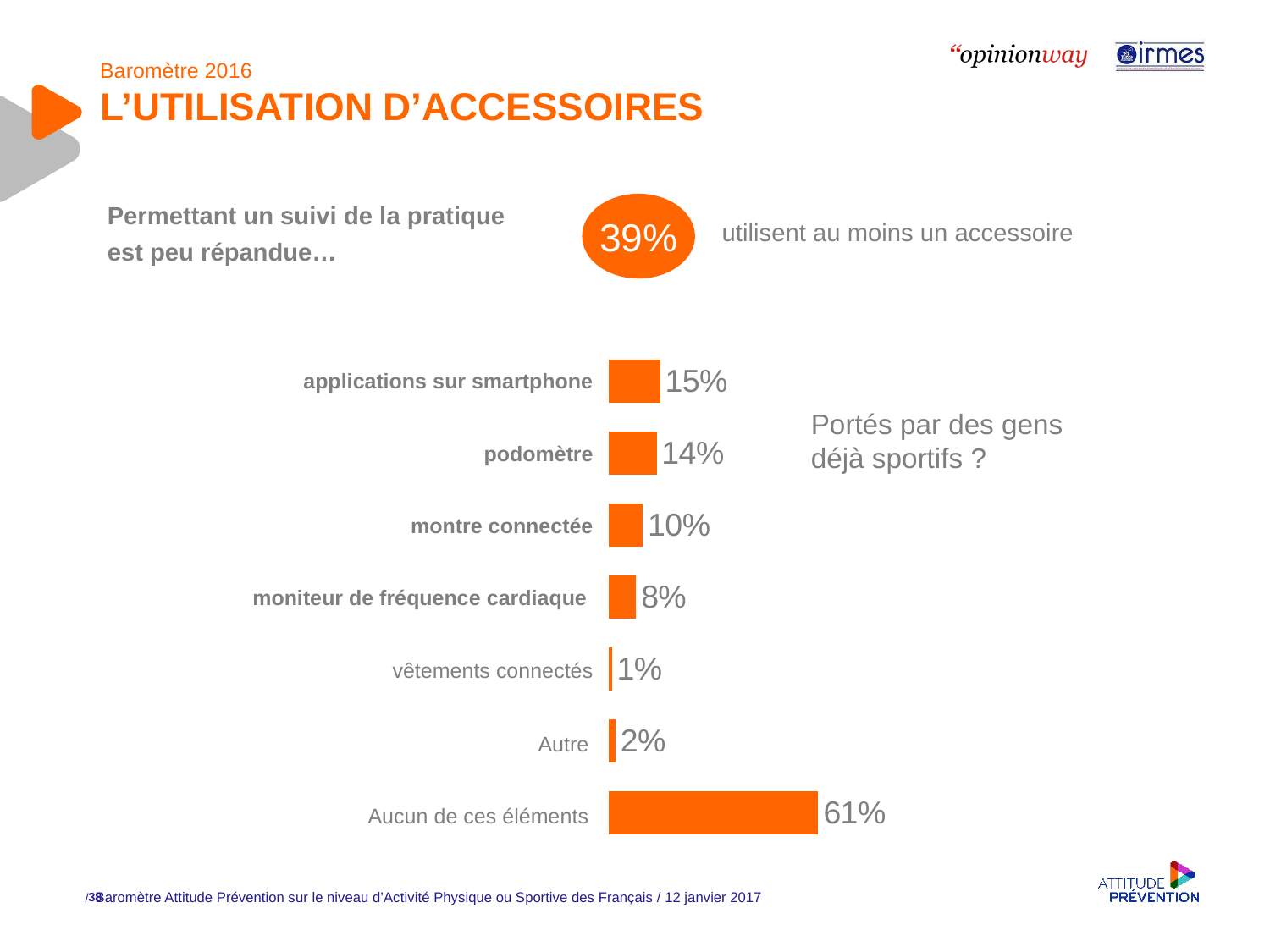
Which category has the lowest value? vêtements connectés What is the value for moniteur de fréquence cardiaque? 8% What is the value for podomètre? 14% What is the value for montre connectée? 10% What is the value for applications sur smartphone? 15% Which is larger, the value for montre connectée or the value for moniteur de fréquence cardiaque? montre connectée What is the difference between the values for Aucun de ces éléments and applications sur smartphone? 46% What is the value for Aucun de ces éléments? 61% What is the value for vêtements connectés? 1% What kind of chart is shown on the slide? bar chart How many categories are shown in the chart? 7 Which category has the highest value? Aucun de ces éléments